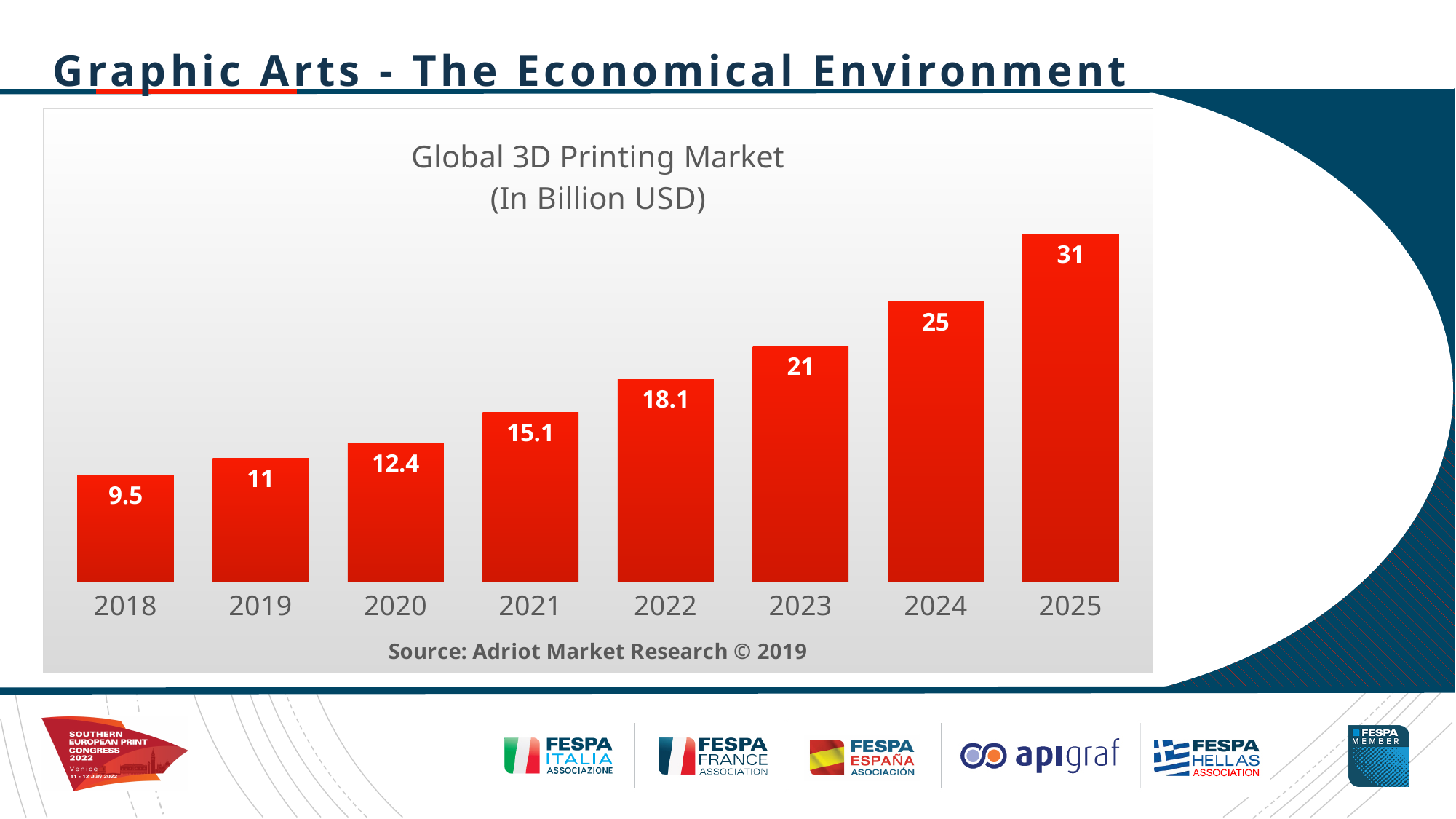
Which year has the lowest value in the Global 3D Printing Market chart? 2018 Which year has the highest value in the Global 3D Printing Market chart? 2025 What is the difference between the values for 2021 and 2020 in the Global 3D Printing Market chart? 2.7 What is the value for 2022 in the Global 3D Printing Market chart? 18.1 What is the value for 2025 in the Global 3D Printing Market chart? 31 What is the difference between the values for 2025 and 2018 in the Global 3D Printing Market chart? 21.5 How many years are shown in the Global 3D Printing Market chart? 8 Which is larger in the Global 3D Printing Market chart, the value for 2023 or the value for 2024? 2024 What unit is given in the title of the Global 3D Printing Market chart? Billion USD What is the value for 2018 in the Global 3D Printing Market chart? 9.5 Do the values in the Global 3D Printing Market chart rise or fall from 2018 to 2025? rise What kind of chart is the Global 3D Printing Market chart? bar chart